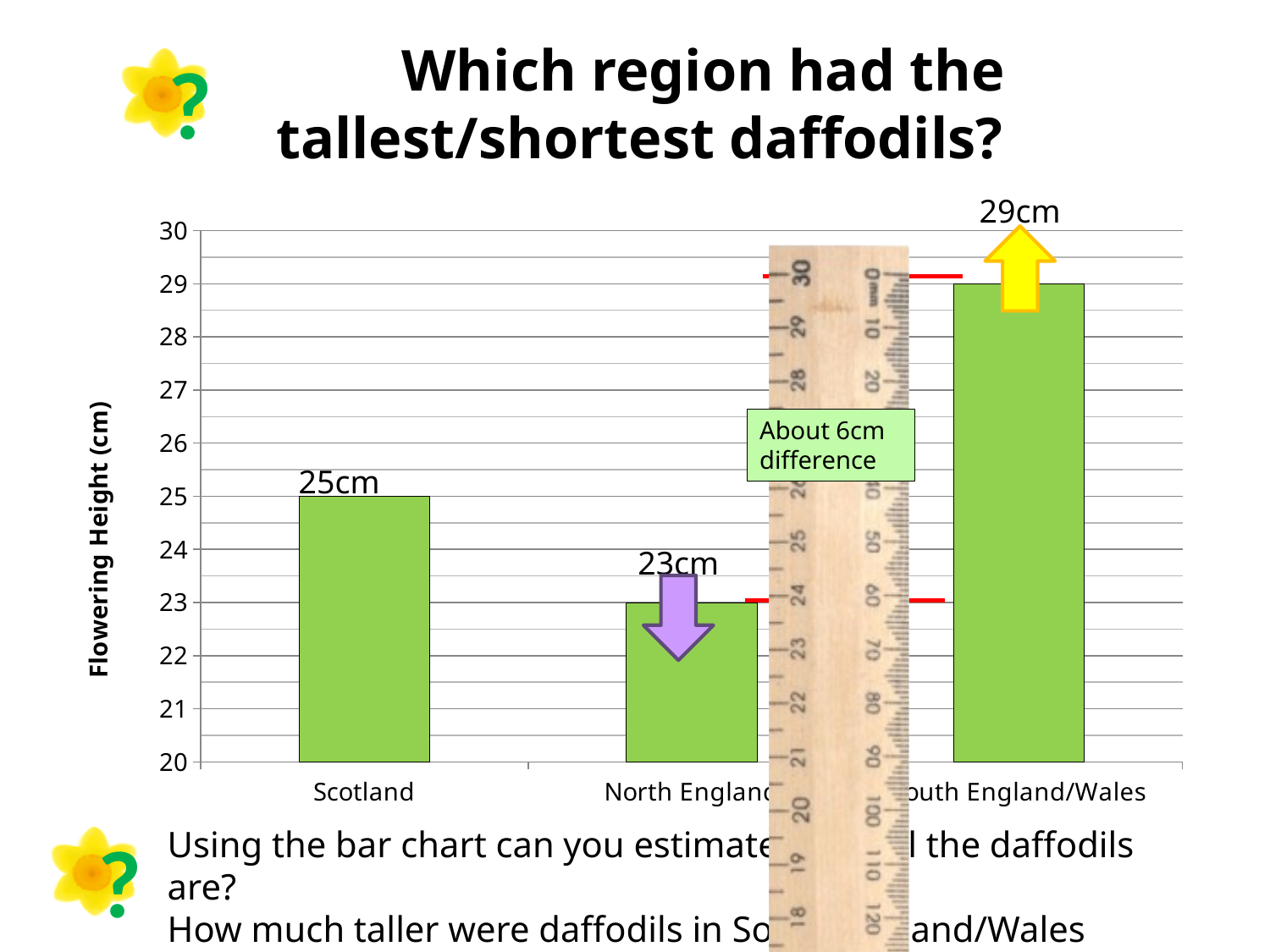
What kind of chart is shown on the slide? bar chart How many regions are shown in the bar chart? 3 Which region has the tallest daffodils? South England/Wales How much taller were the daffodils in South England/Wales than in North England? 6cm What is the flowering height for Scotland? 25cm Which region has the shortest daffodils? North England What is the difference in flowering height between Scotland and North England? 2cm What is the flowering height for South England/Wales? 29cm Which has the greater flowering height, Scotland or North England? Scotland Is the flowering height for Scotland greater or less than 24? greater What is the label on the vertical axis of the chart? Flowering Height (cm) What is the flowering height for North England? 23cm